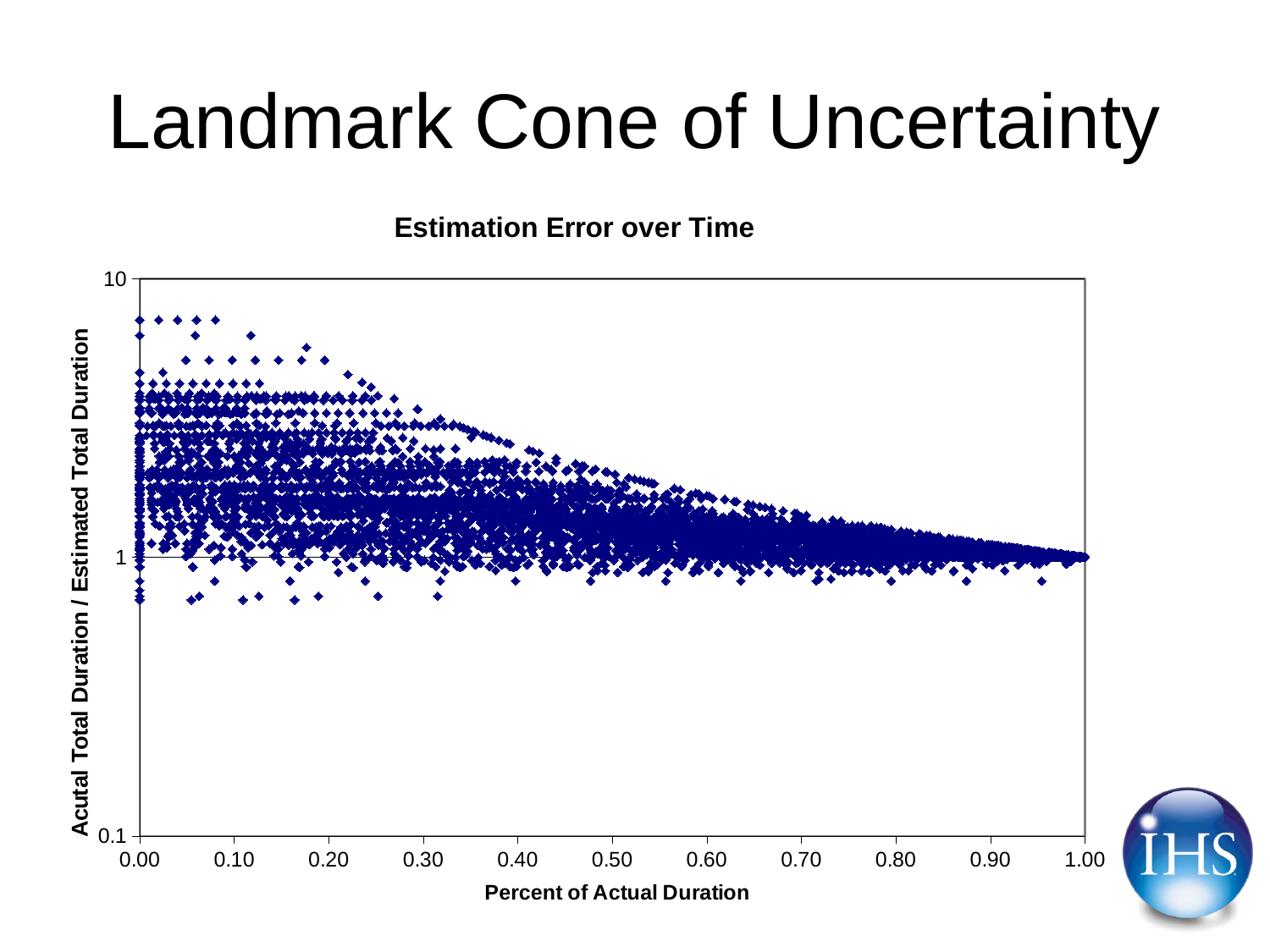
Is the lowest plotted point greater or less than 0.1 on the y axis? greater What is the label of the x axis? Percent of Actual Duration What is the largest tick value shown on the x axis? 1.00 Are the points near a Percent of Actual Duration of 0.00 mostly greater or less than 1 on the y axis? greater What kind of chart is shown on the slide? scatter chart As Percent of Actual Duration increases toward 1.00, does the spread of the plotted points widen or narrow? narrow What is the title of the chart? Estimation Error over Time What is the highest tick value shown on the y axis? 10 Toward which y-axis value do the points converge at a Percent of Actual Duration of 1.00? 1 Is the highest plotted point greater or less than 10 on the y axis? less